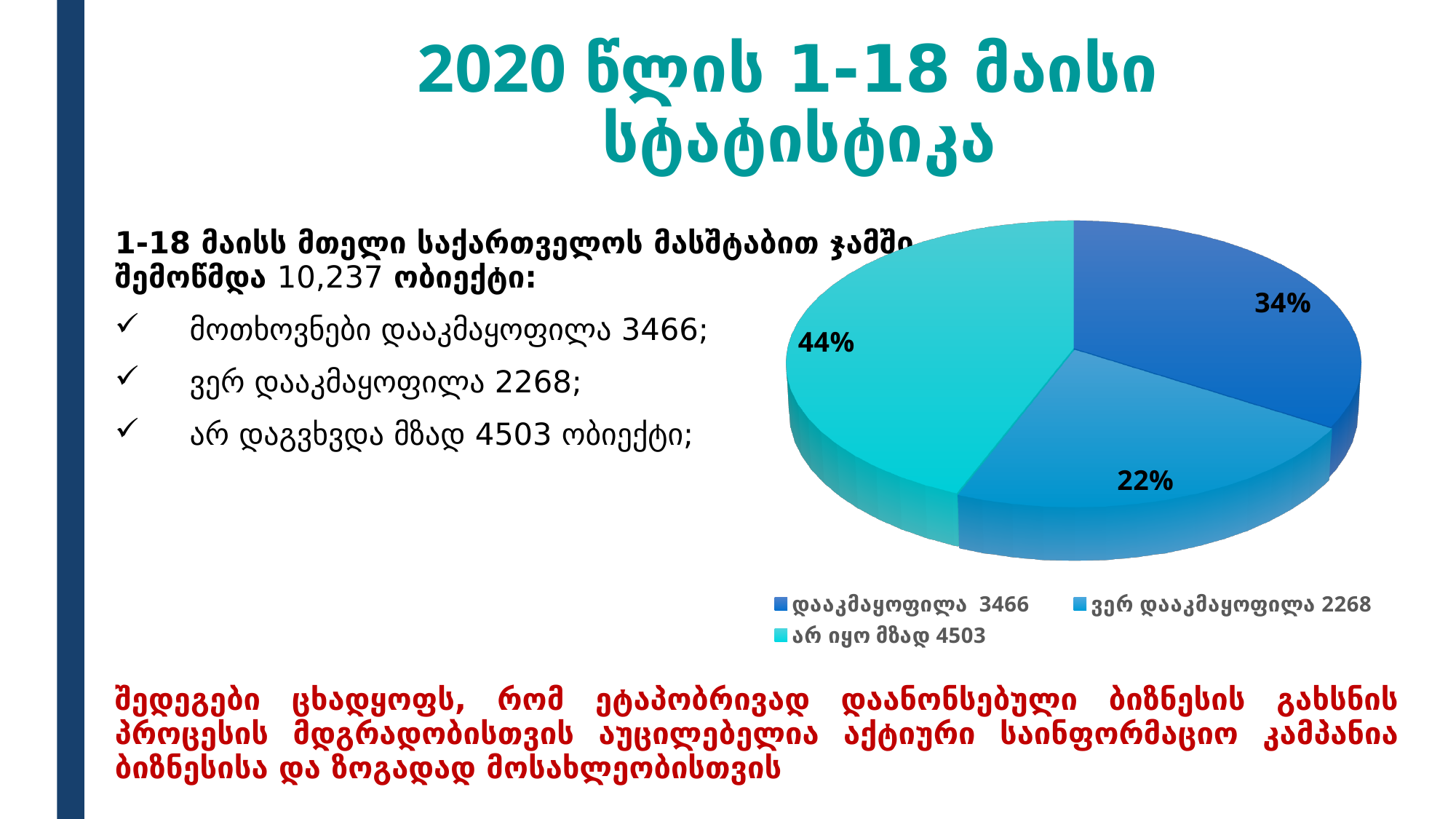
What is the difference in percentage points between the "არ იყო მზად" slice and the "ვერ დააკმაყოფილა" slice? 22 What percentage is shown for the slice "დააკმაყოფილა"? 34% Which slice of the pie chart is the smallest? ვერ დააკმაყოფილა What is the total of the three counts shown in the legend (3466, 2268 and 4503)? 10,237 Which is larger: the slice "დააკმაყოფილა" or the slice "ვერ დააკმაყოფილა"? დააკმაყოფილა According to the legend, what count is given for "არ იყო მზად"? 4503 How many entries does the legend of the pie chart list? 3 Which slice of the pie chart is the largest? არ იყო მზად What percentage is shown for the slice "ვერ დააკმაყოფილა"? 22% What percentage is shown for the slice "არ იყო მზად"? 44% What kind of chart is shown on the slide? pie chart How many slices does the pie chart have? 3